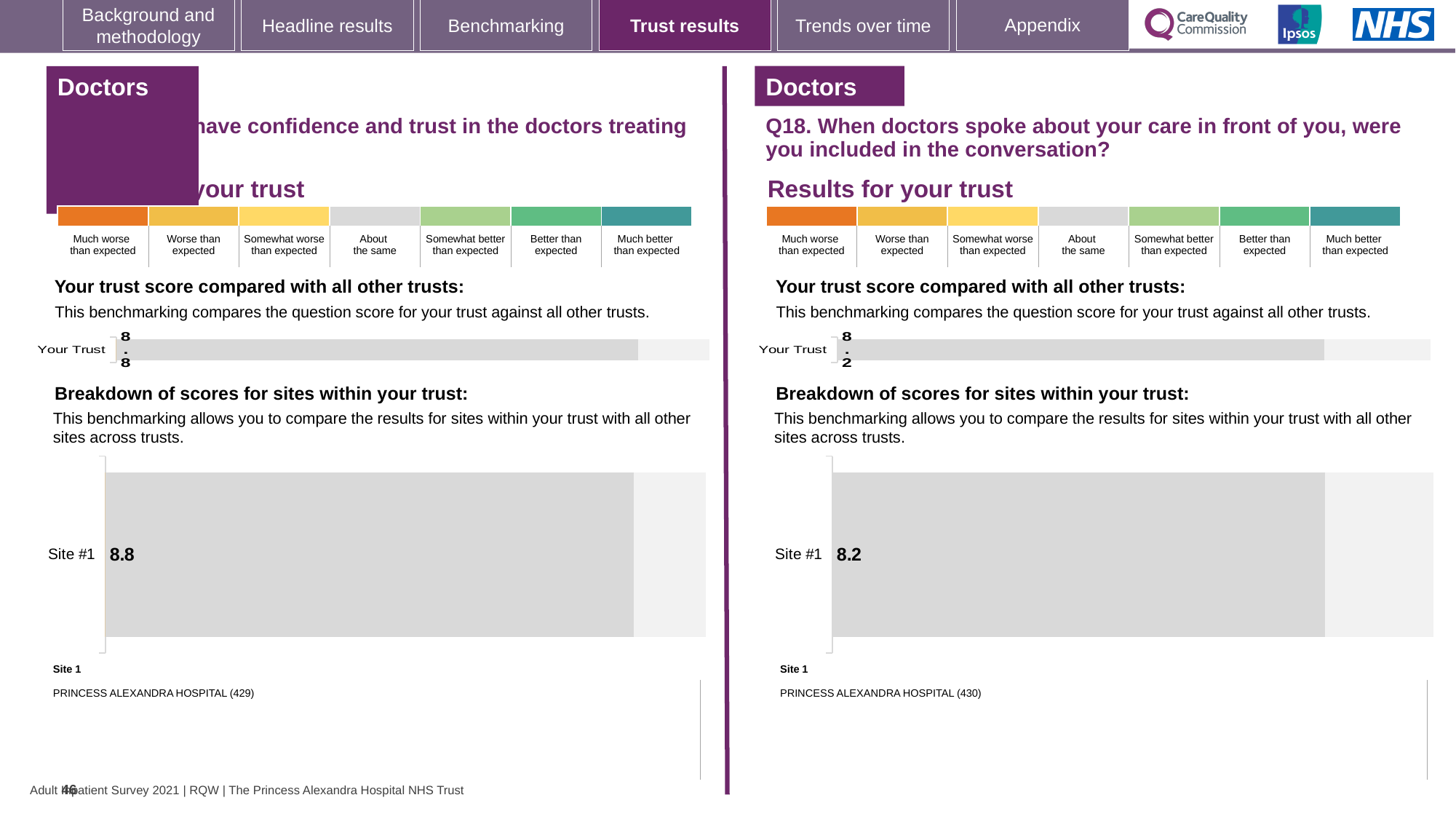
Is the Your Trust score on the right-hand (Q18) chart greater or less than the Your Trust score on the left-hand chart? less In the site breakdown chart on the left-hand side of the slide, what is the score for Site #1? 8.8 What type of chart is used to show the Site #1 score in the Q18 breakdown on the right? Bar chart In the site breakdown chart on the left-hand side, which site is listed as Site 1? PRINCESS ALEXANDRA HOSPITAL (429) How many sites are shown in the Q18 site breakdown chart on the right? 1 On the right-hand side of the slide (Q18), what is the score shown for Your Trust? 8.2 What is the difference between the Site #1 score on the left-hand chart (8.8) and the Site #1 score on the right-hand Q18 chart (8.2)? 0.6 In the Q18 site breakdown chart on the right, what is the score for Site #1? 8.2 On the left-hand side of the slide, what is the score shown for Your Trust? 8.8 In the Q18 site breakdown chart on the right, which site is listed as Site 1? PRINCESS ALEXANDRA HOSPITAL (430) Which is larger: the Site #1 score in the left-hand site breakdown chart or the Site #1 score in the right-hand (Q18) site breakdown chart? Left-hand chart (8.8)